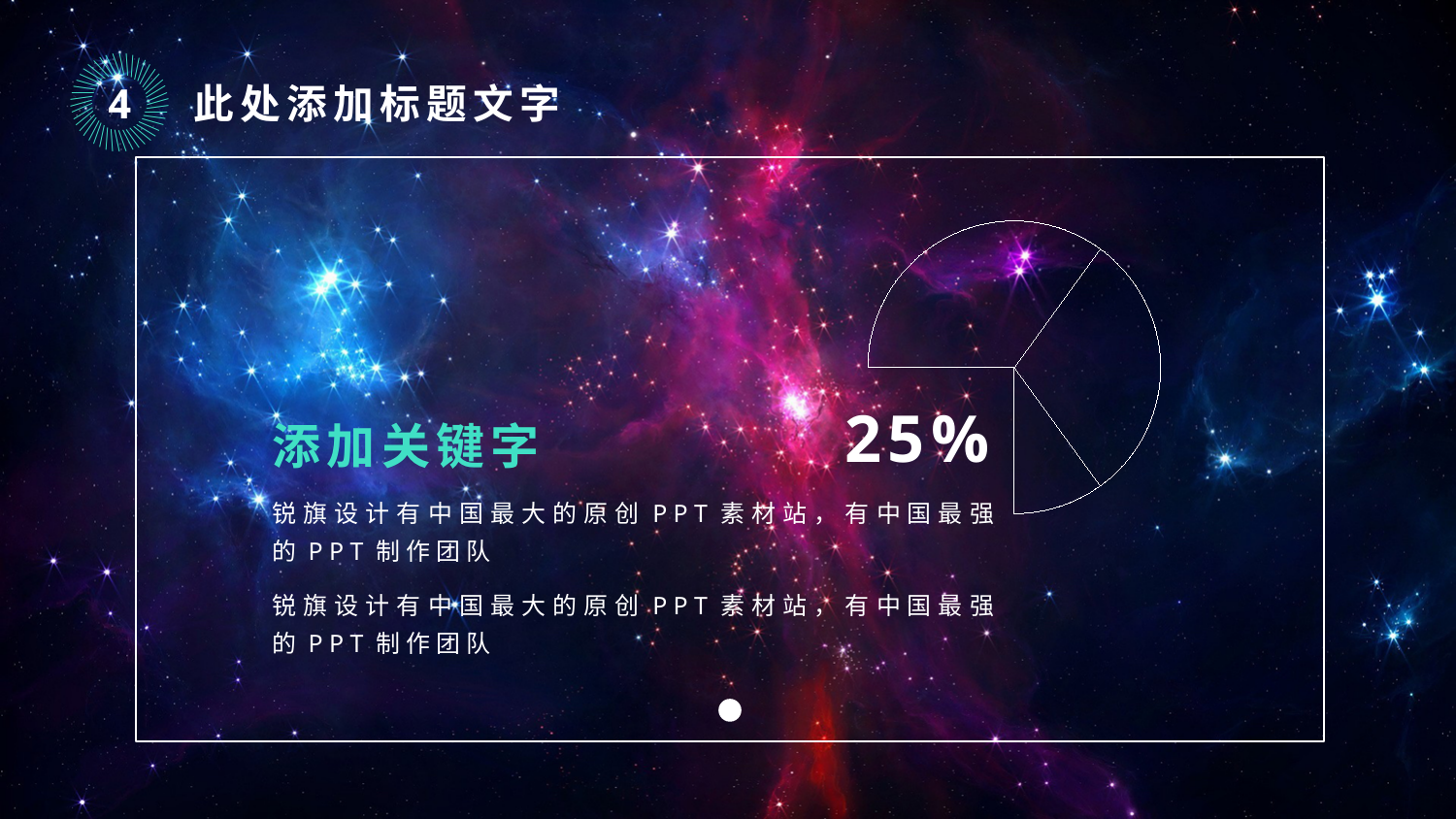
Is the pie chart drawn as a filled chart or as an outline? outline What kind of chart is shown on the slide? pie chart Does the pie chart on the slide have a legend? No What percentage value is printed next to the pie chart? 25%